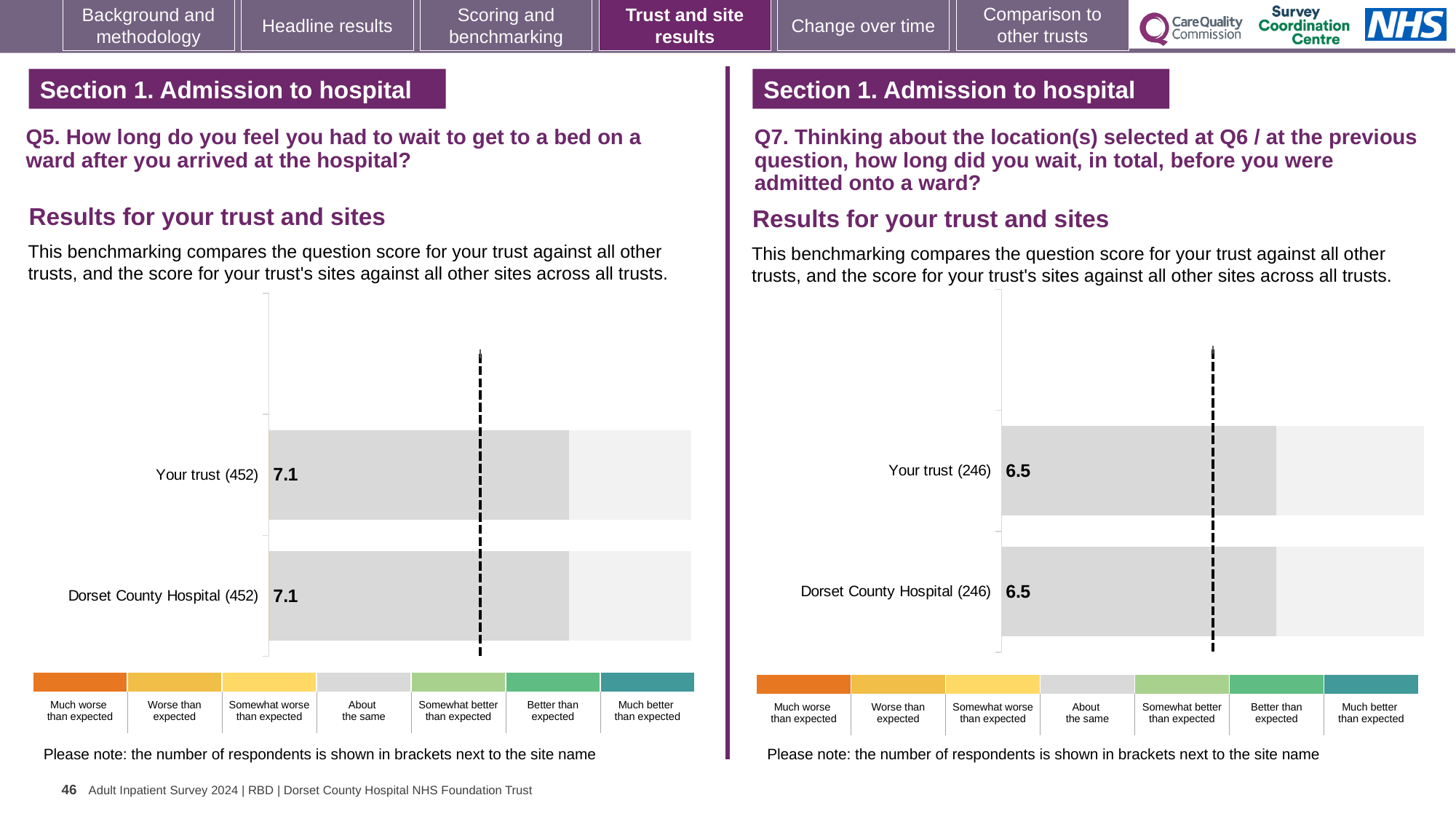
In the Q5 chart on the left, what is the difference between the score for Your trust and the score for Dorset County Hospital? 0 In the Q5 chart on the left, how many respondents are shown in brackets for Dorset County Hospital? 452 In the Q7 chart on the right, what is the score for Dorset County Hospital? 6.5 In the Q5 chart on the left, what is the score for Dorset County Hospital? 7.1 In the Q5 chart on the left, which benchmark category does the colour of the bars correspond to in the legend below? About the same In the Q7 chart on the right, how many respondents are shown in brackets for Your trust? 246 How many bars are plotted in the Q5 chart on the left? 2 What kind of chart is the Q7 chart on the right? Bar chart In the Q7 chart on the right, what is the difference between the score for Your trust and the score for Dorset County Hospital? 0 In the Q7 chart on the right, what is the score for Your trust? 6.5 How many bars are plotted in the Q7 chart on the right? 2 In the Q5 chart on the left, what is the score for Your trust? 7.1